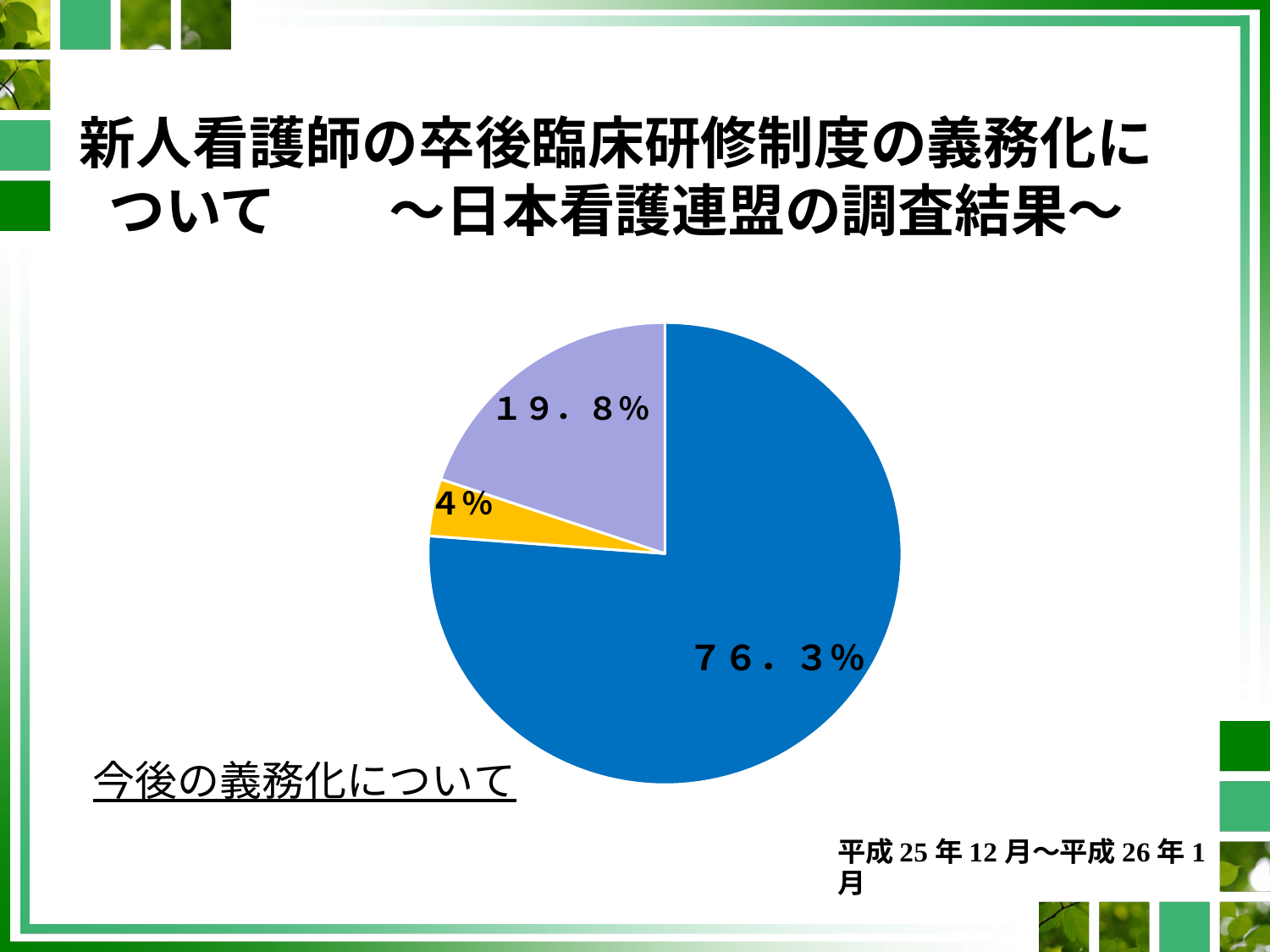
What percentage is shown on the light purple slice of the pie chart? 19.8% What percentage is shown on the yellow slice of the pie chart? 4% What is the difference between the blue slice (76.3%) and the light purple slice (19.8%)? 56.5% What is the underlined label written below the pie chart? 今後の義務化について What is the value shown on the largest slice of the pie chart? 76.3% What percentage is shown on the blue slice of the pie chart? 76.3% What is the difference between the light purple slice (19.8%) and the yellow slice (4%)? 15.8% Which slice is larger, the light purple slice or the yellow slice? the light purple slice What is the value shown on the smallest slice of the pie chart? 4% How many slices does the pie chart have? 3 What share of the pie does the blue slice represent? 76.3% What kind of chart is shown on the slide? pie chart